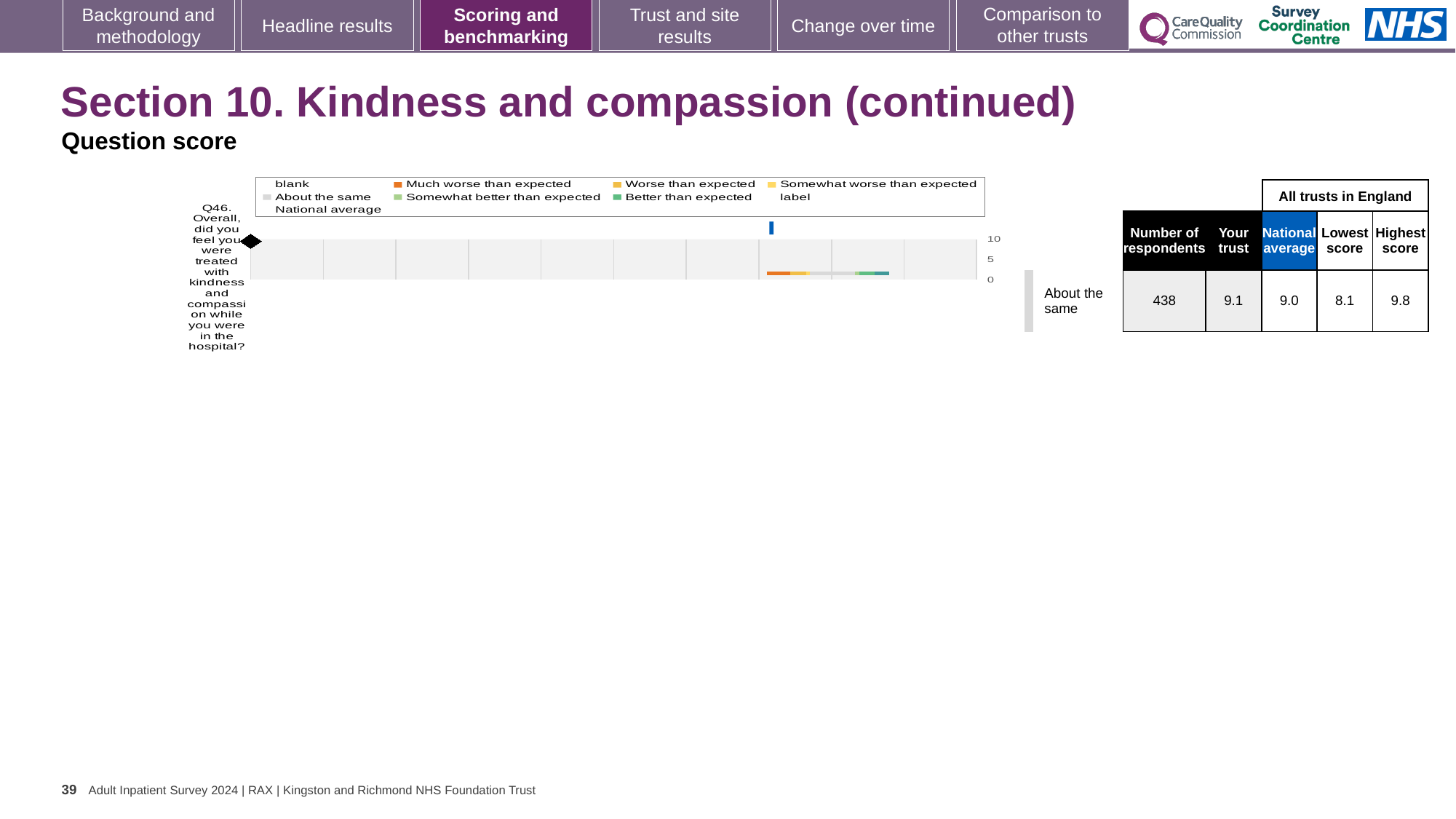
How many questions (categories) are plotted on the chart? 1 In the table beside the chart, what is the highest score among all trusts in England for Q46? 9.8 What is the highest tick value shown on the chart's axis? 10 Which is larger for Q46: the 'Your trust' score or the national average? Your trust In the table beside the chart, what is the number of respondents for Q46? 438 Which question is plotted on the chart? Q46. Overall, did you feel you were treated with kindness and compassion while you were in the hospital? What kind of chart is shown on the slide? bar chart How many entries does the chart's legend list? 9 In the table beside the chart, what is the 'Your trust' score for Q46? 9.1 In the table beside the chart, what is the lowest score among all trusts in England for Q46? 8.1 What is the difference between the highest score and the lowest score for Q46 in the table beside the chart? 1.7 In the table beside the chart, what is the national average score for Q46? 9.0